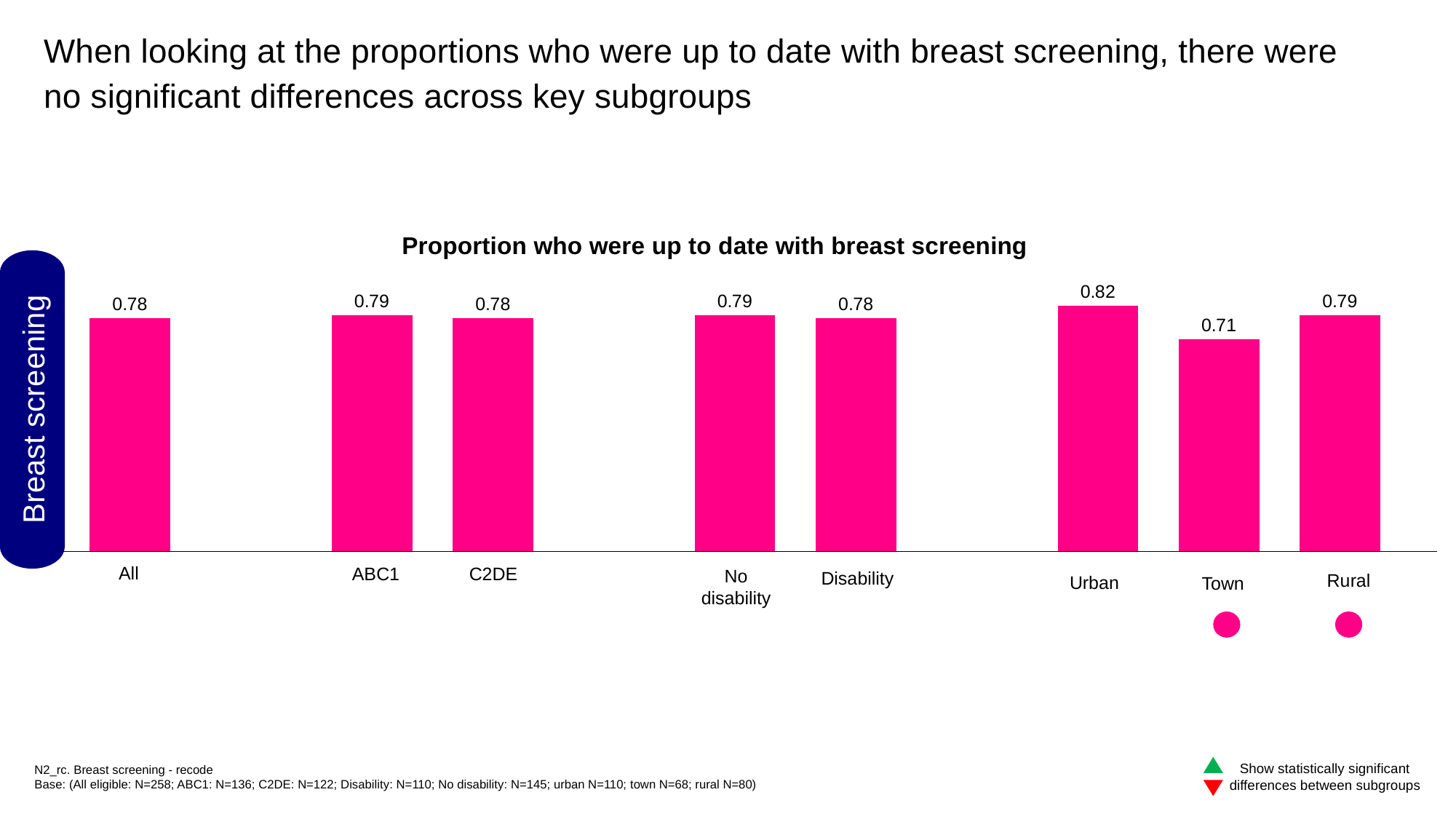
Which category has the highest value? Urban Which is larger, the value for Rural or the value for Town? Rural Which category has the lowest value? Town What is the value for All? 0.78 What is the difference between the values for No disability and Disability? 0.01 How many categories are shown in the chart? 8 What is the value for Urban? 0.82 What kind of chart is shown on the slide? Bar chart What is the value for ABC1? 0.79 What is the value for Town? 0.71 What is the title of the chart? Proportion who were up to date with breast screening What is the difference between the values for Urban and Town? 0.11